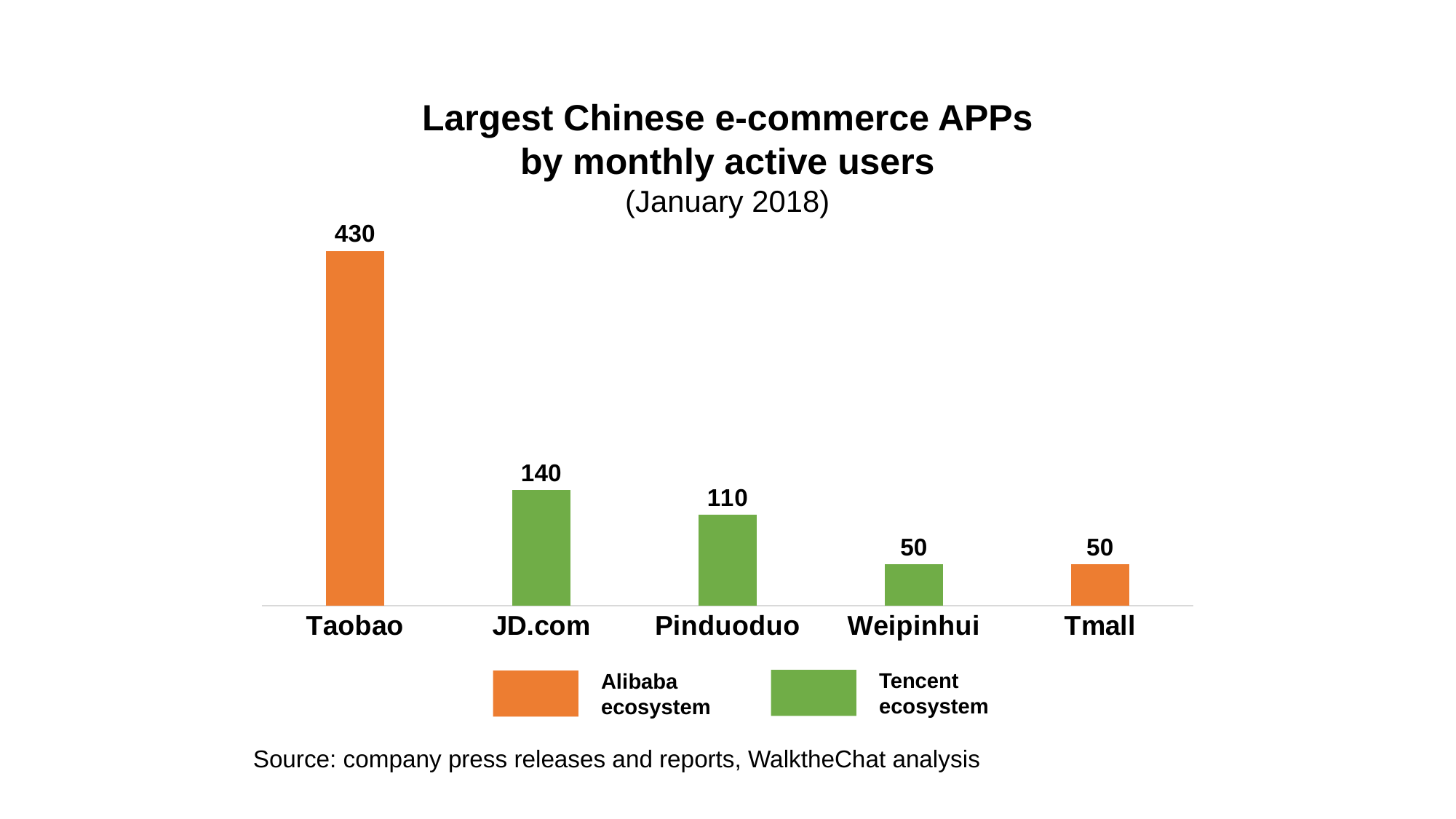
What is the value for JD.com? 140 What is the difference between the values for JD.com and Pinduoduo? 30 What is the value for Taobao? 430 What is the value for Weipinhui? 50 What kind of chart is this? Bar chart Which is larger, the value for JD.com or the value for Pinduoduo? JD.com How many apps are shown on the chart? 5 How many series does the legend list? 2 Which app has the highest monthly active users? Taobao What is the value for Pinduoduo? 110 What is the difference between the values for Taobao and JD.com? 290 Which ecosystem does the legend associate with the green bars? Tencent ecosystem